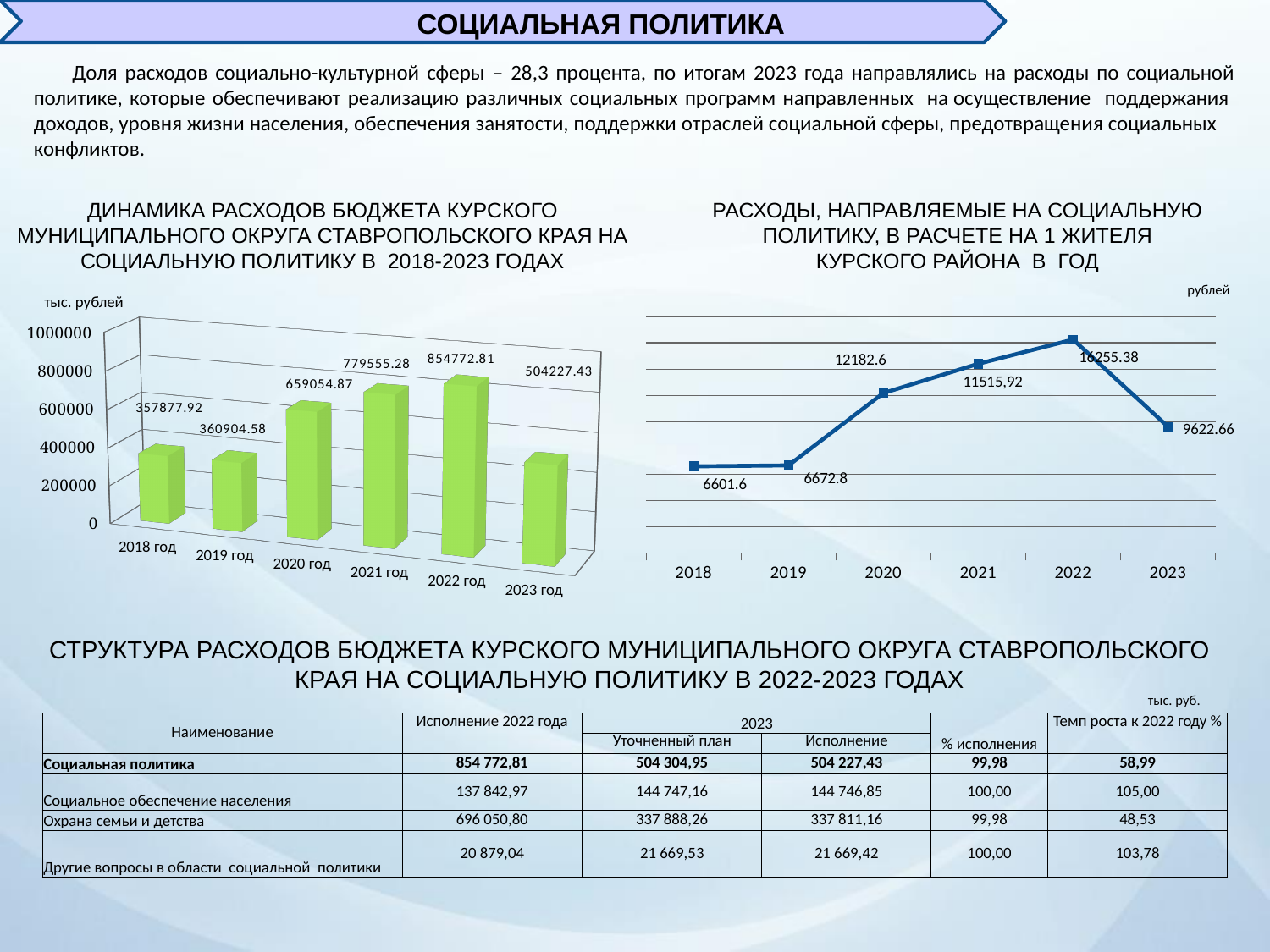
In the left chart (dynamics of social policy expenditures 2018-2023), what is the difference between the values for 2022 год and 2023 год? 350545.38 What type of chart is the right chart (expenditures on social policy per 1 resident per year)? Line chart In the right chart (expenditures on social policy per 1 resident per year), what is the value for 2022? 16255.38 What type of chart is the left chart (dynamics of social policy expenditures 2018-2023)? Bar chart In the left chart (dynamics of social policy expenditures 2018-2023), which year has the lowest value? 2018 год In the left chart (dynamics of social policy expenditures 2018-2023), what is the value for 2018 год? 357877.92 In the right chart (expenditures on social policy per 1 resident per year), which year has the lowest value? 2018 In the left chart (dynamics of social policy expenditures 2018-2023), what is the value for 2022 год? 854772.81 In the left chart (dynamics of social policy expenditures 2018-2023), how many years are plotted? 6 In the right chart (expenditures on social policy per 1 resident per year), what is the value for 2019? 6672.8 In the left chart (dynamics of social policy expenditures 2018-2023), which year has the highest value? 2022 год